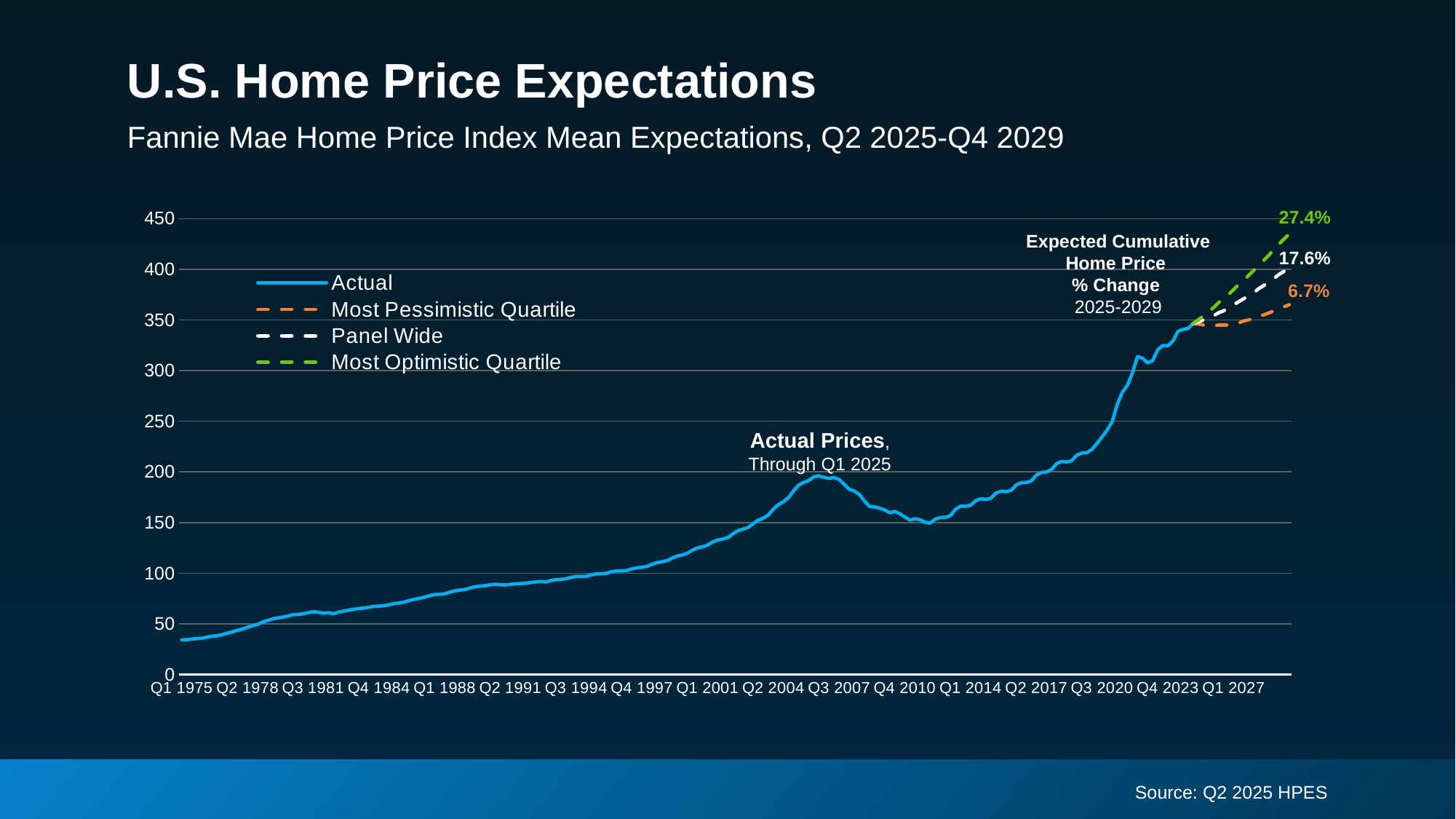
What kind of chart is shown on the slide? line chart What is the expected cumulative home price % change for 2025-2029 for the Panel Wide series? 17.6% Which series has the lowest expected cumulative home price % change for 2025-2029? Most Pessimistic Quartile What is the expected cumulative home price % change for 2025-2029 for the Most Optimistic Quartile? 27.4% Which series has the highest expected cumulative home price % change for 2025-2029? Most Optimistic Quartile Is the Actual home price index value at Q1 1975 greater or less than 50? less Overall, does the Actual home price index rise or fall from Q1 1975 to Q1 2025? rise What is the difference between the Panel Wide and Most Pessimistic Quartile expected cumulative % change for 2025-2029? 10.9% What is the expected cumulative home price % change for 2025-2029 for the Most Pessimistic Quartile? 6.7% How many series does the legend list? 4 What is the difference between the Most Optimistic Quartile and Most Pessimistic Quartile expected cumulative % change for 2025-2029? 20.7% Is the Actual home price index value at Q1 2025 greater or less than 300? greater